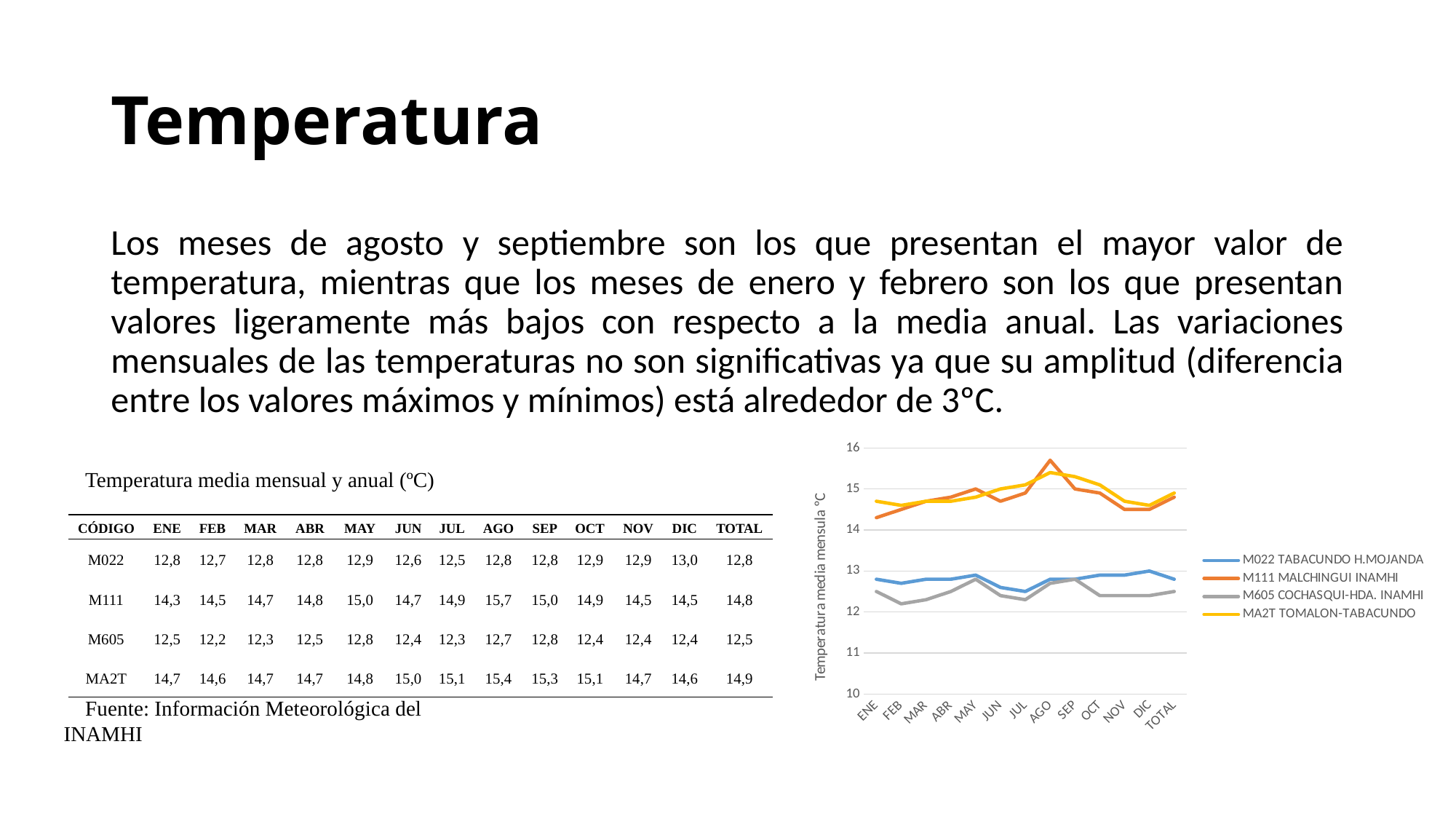
Is the value for M111 MALCHINGUI INAMHI in AGO greater or less than 15? greater Is the value for M605 COCHASQUI-HDA. INAMHI in FEB greater or less than 13? less In which month does the M605 COCHASQUI-HDA. INAMHI series reach its lowest value? FEB Does the M111 MALCHINGUI INAMHI series rise or fall from ENE to MAY? rise What is the title of the chart's vertical axis? Temperatura media mensula °C How many categories are shown along the x axis of the chart? 13 What is the difference between the AGO values of M111 MALCHINGUI INAMHI and M605 COCHASQUI-HDA. INAMHI, using the values printed in the table? 3,0 In ENE, which series has the higher value: MA2T TOMALON-TABACUNDO or M111 MALCHINGUI INAMHI? MA2T TOMALON-TABACUNDO What kind of chart is shown on the slide? line chart In which month does the M111 MALCHINGUI INAMHI series reach its highest value? AGO How many series does the chart's legend list? 4 What is the value for M111 MALCHINGUI INAMHI in AGO, as printed in the table on the slide? 15,7